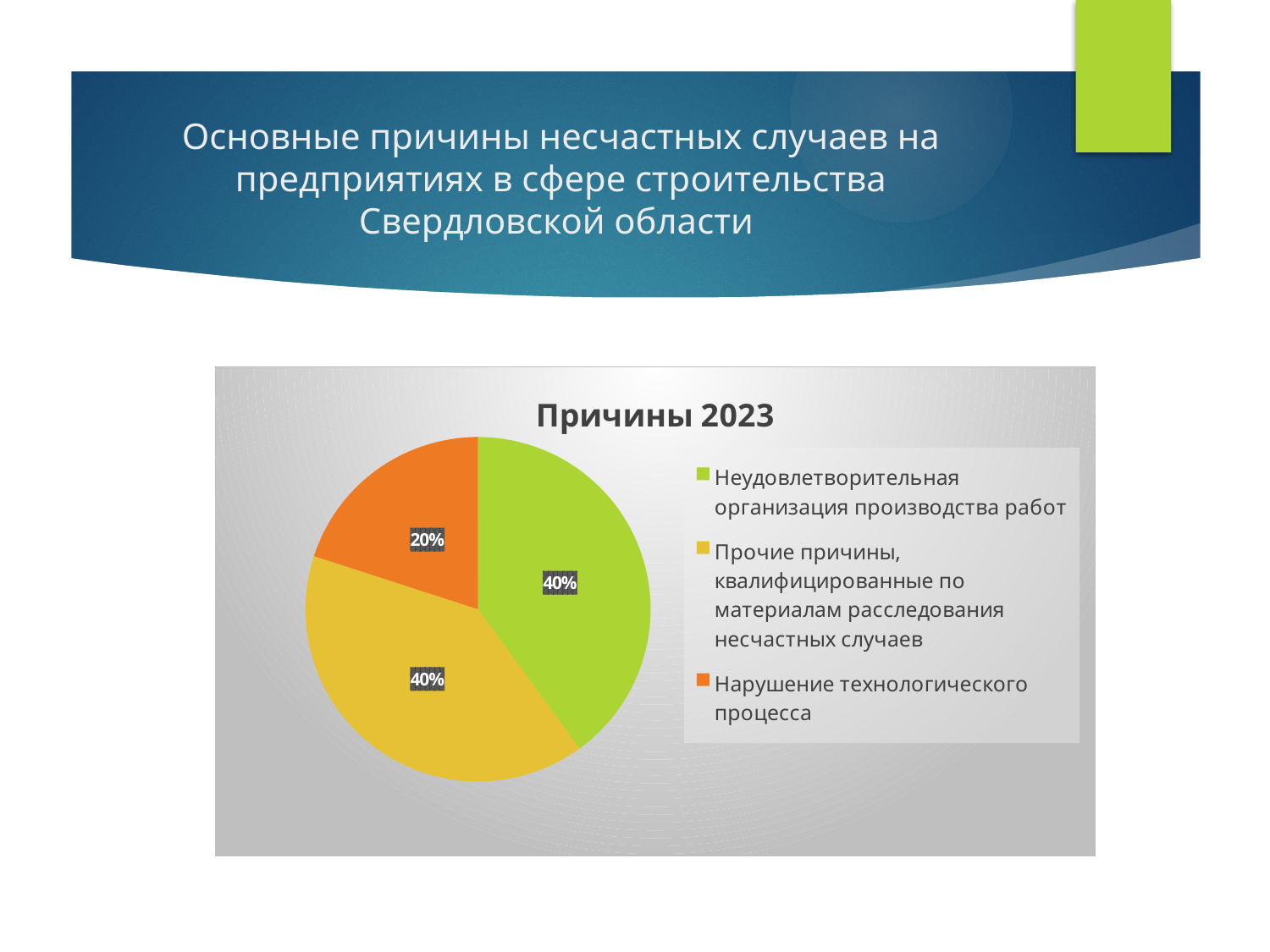
Which is larger: the slice for 'Неудовлетворительная организация производства работ' or the slice for 'Нарушение технологического процесса'? Неудовлетворительная организация производства работ What is the title of the chart? Причины 2023 What share of the pie is 'Неудовлетворительная организация производства работ'? 40% What colour is the slice for 'Нарушение технологического процесса'? Orange How many slices does the pie chart have? 3 How many entries does the legend list? 3 What kind of chart is shown on the slide? Pie chart Which category has the smallest slice of the pie? Нарушение технологического процесса Is the share for 'Нарушение технологического процесса' greater or less than 25%? less What share of the pie is 'Прочие причины, квалифицированные по материалам расследования несчастных случаев'? 40% What is the difference in percentage points between 'Прочие причины, квалифицированные по материалам расследования несчастных случаев' and 'Нарушение технологического процесса'? 20 percentage points What share of the pie is 'Нарушение технологического процесса'? 20%